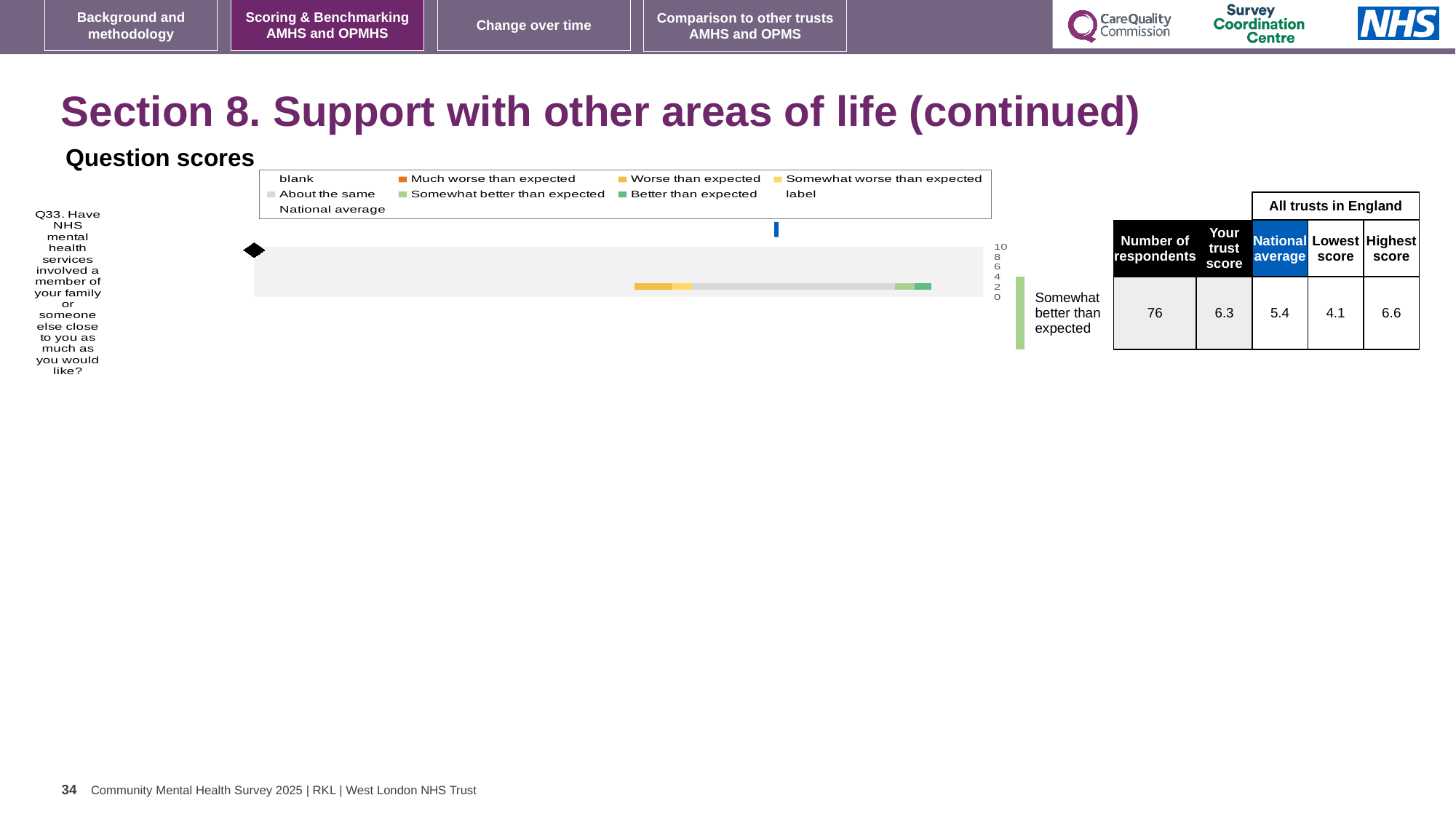
In the table next to the chart, what is the national average for Q33? 5.4 In the table next to the chart, what is the lowest score among all trusts in England for Q33? 4.1 How many questions are plotted in the question scores chart? 1 In the table next to the chart, what is the highest score among all trusts in England for Q33? 6.6 How many entries does the legend of the question scores chart list? 9 What rating category is shown beside the chart for Q33? Somewhat better than expected What kind of chart is used to show the Q33 question score? bar chart In the table next to the chart, what is the number of respondents for Q33? 76 For Q33, what is the difference between the highest score and the lowest score among all trusts in England? 2.5 Which question is plotted in the question scores chart? Q33. Have NHS mental health services involved a member of your family or someone else close to you as much as you would like? In the table next to the chart, what is your trust score for Q33? 6.3 For Q33, which is larger: your trust score or the national average? Your trust score